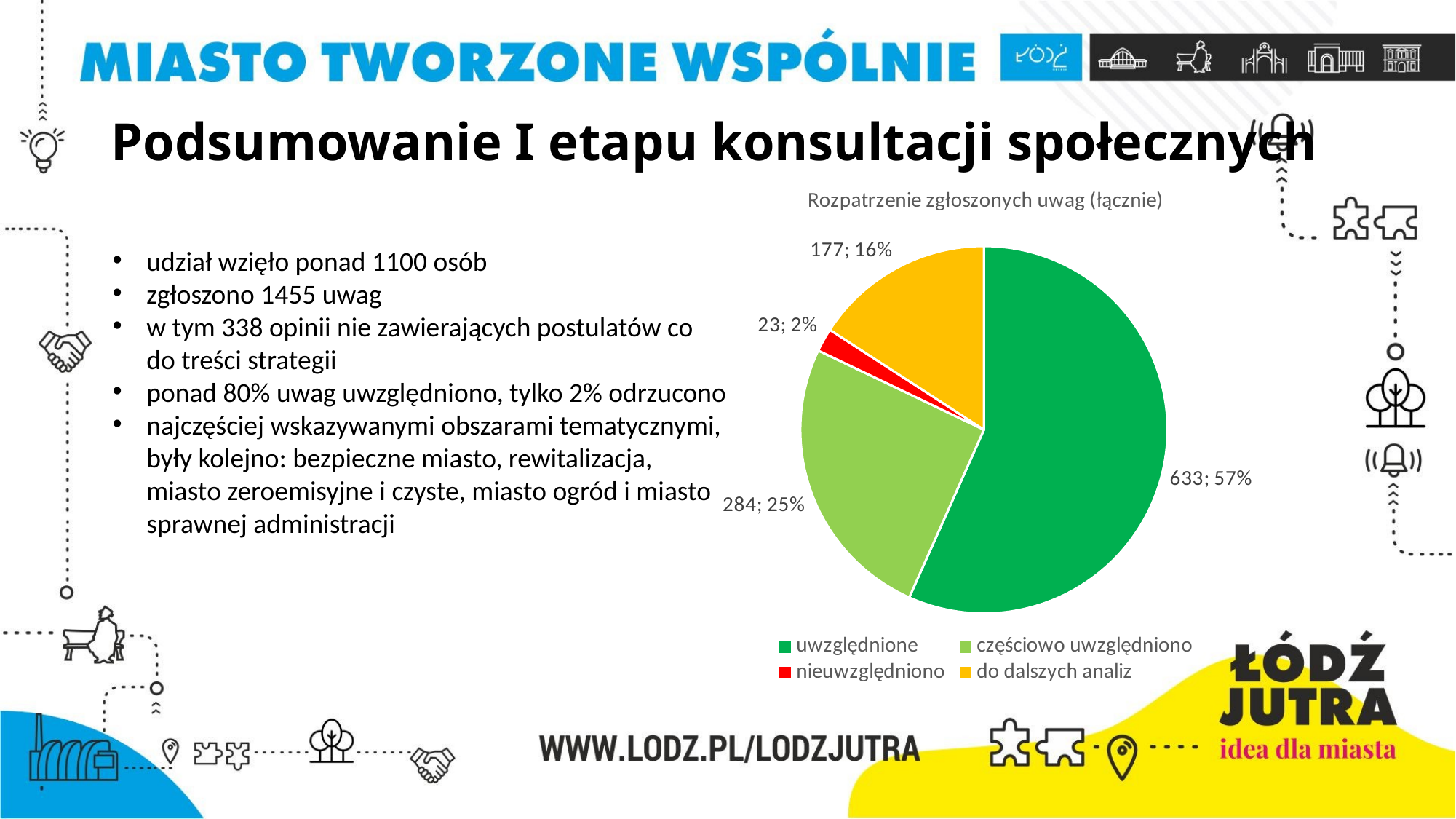
What is the difference between the values for 'częściowo uwzględniono' and 'do dalszych analiz'? 107 How many slices does the pie chart have? 4 How many entries does the chart legend list? 4 What is the title of the chart? Rozpatrzenie zgłoszonych uwag (łącznie) Which category has the smallest slice? nieuwzględniono Which category has the largest slice? uwzględnione What is the value for 'uwzględnione'? 633 What share of the pie does 'uwzględnione' represent? 57% What is the value for 'nieuwzględniono'? 23 What is the value for 'częściowo uwzględniono'? 284 What share of the pie does 'do dalszych analiz' represent? 16% What type of chart is shown on the slide? pie chart